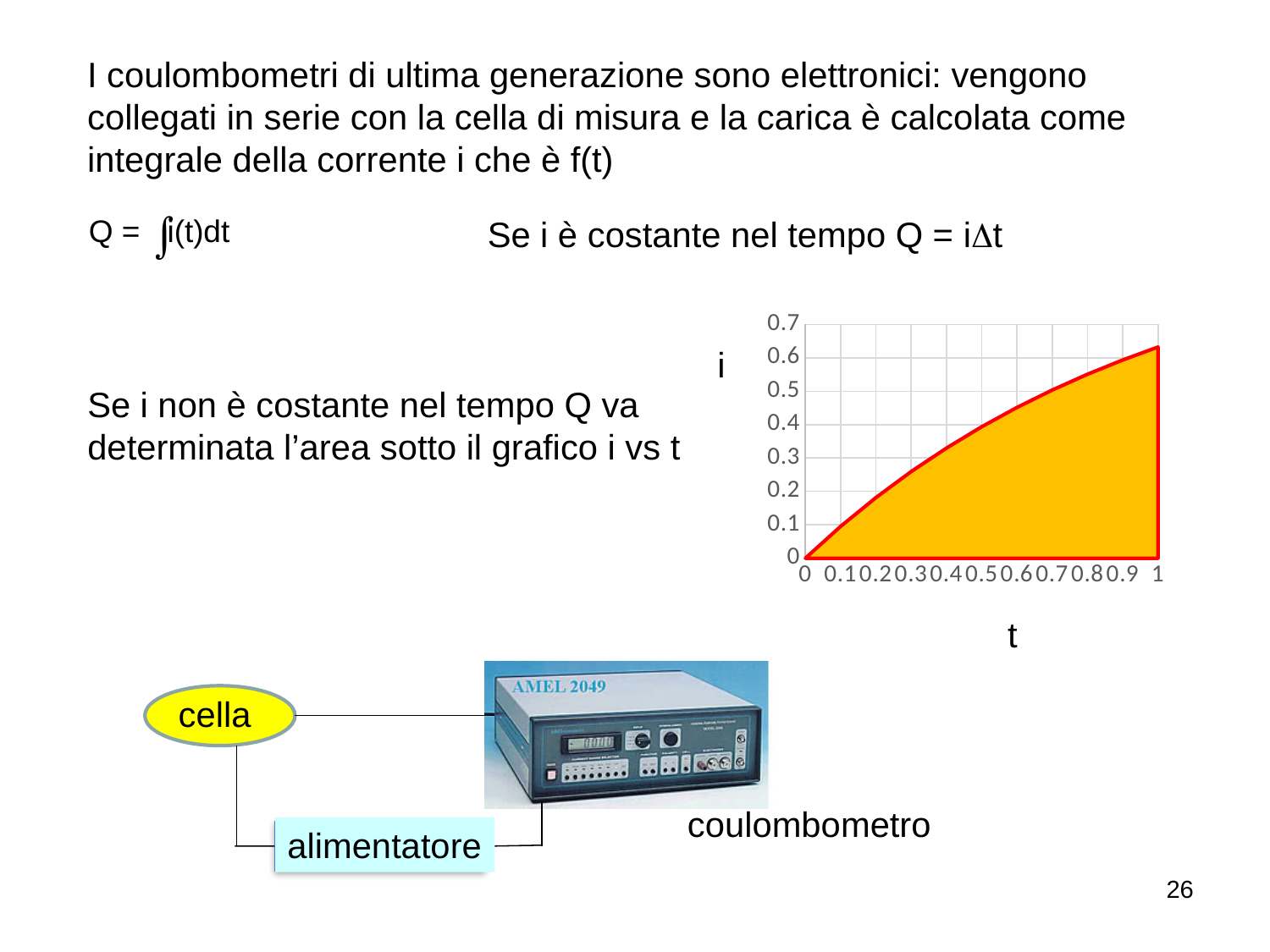
What is the value of i at t = 0? 0 Does the value of i rise or fall as t increases from 0 to 1? rises At which value of t is i lowest? 0 What kind of chart is shown on the slide? area chart What label is given to the vertical axis of the chart? i At which value of t is i highest? 1 Is the value of i at t = 0.5 greater or less than 0.3? greater Is the value of i at t = 1 greater or less than 0.7? less What is the highest tick value shown on the vertical axis of the chart? 0.7 Is the value of i at t = 1 greater or less than 0.5? greater